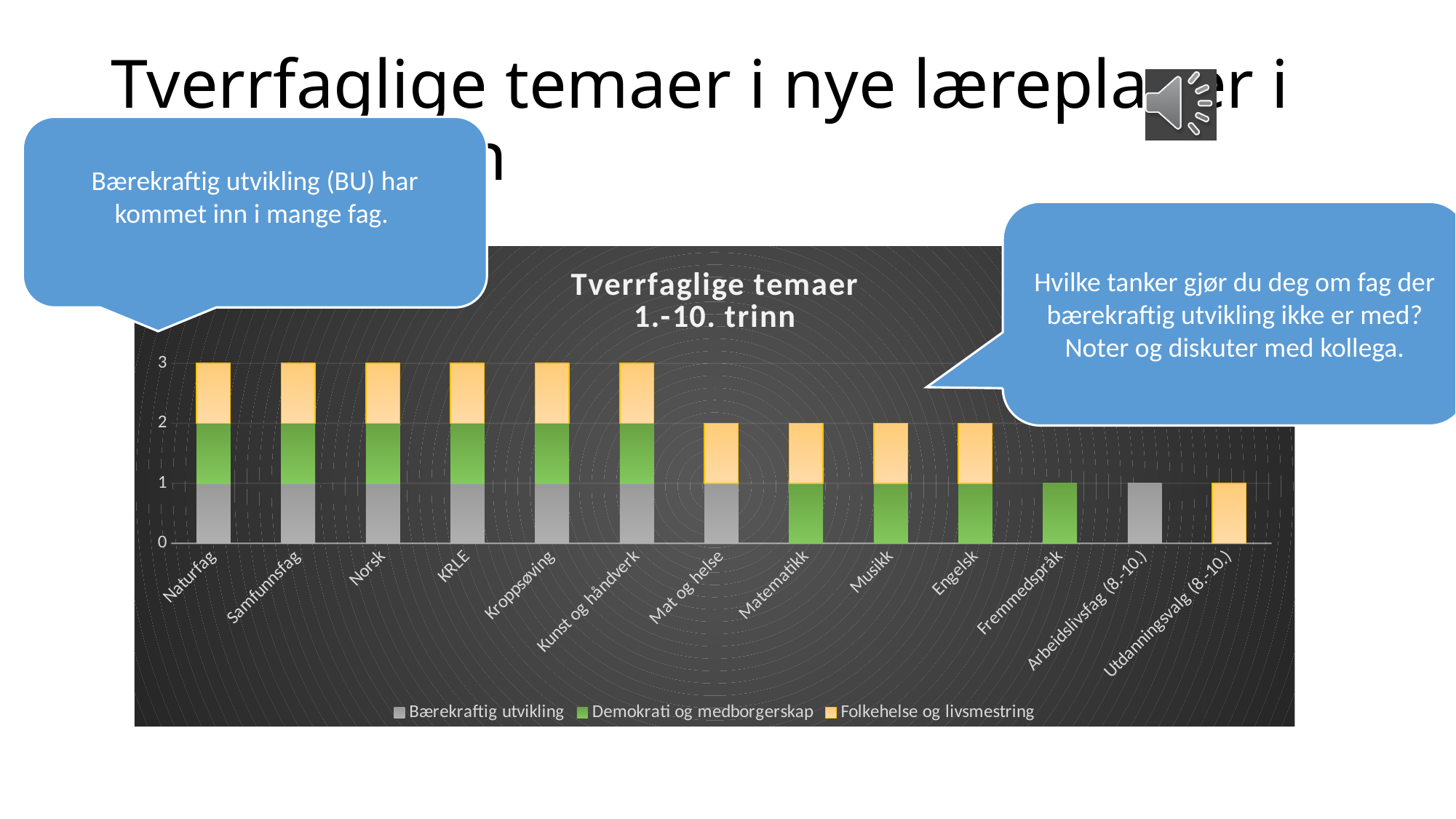
Which colour represents Demokrati og medborgerskap in the chart? Green How many subject categories are shown on the x axis of the chart? 13 What is the total height of the stacked bar for Mat og helse? 2 How many series does the chart legend list? 3 What is the difference between the total bar for Samfunnsfag and the total bar for Engelsk? 1 What kind of chart is shown on the slide? Stacked bar chart What is the title of the chart? Tverrfaglige temaer 1.-10. trinn Which is larger, the total bar for KRLE or the total bar for Musikk? KRLE Which series is the only one present in the bar for Utdanningsvalg (8.-10.)? Folkehelse og livsmestring What is the total height of the stacked bar for Fremmedspråk? 1 What is the total height of the stacked bar for Naturfag? 3 Which series is the only one present in the bar for Arbeidslivsfag (8.-10.)? Bærekraftig utvikling